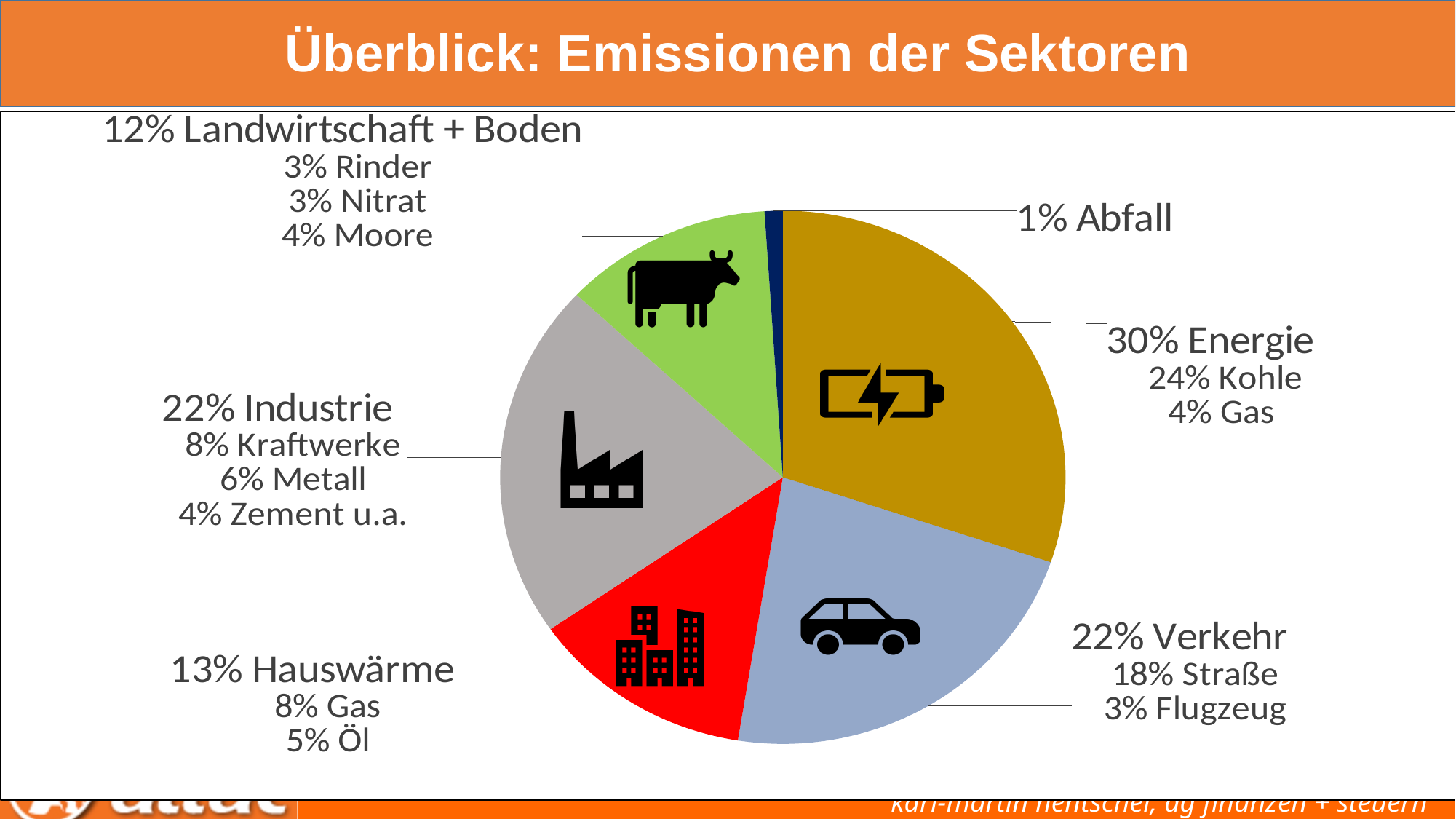
What share of emissions does Abfall account for? 1% What share of emissions does Landwirtschaft + Boden account for? 12% Which has a larger share, Hauswärme or Landwirtschaft + Boden? Hauswärme Which sector has the largest share of emissions? Energie What is the difference in percentage points between the Energie and Verkehr shares? 8 Which sector has the smallest share of emissions? Abfall What kind of chart is shown on the slide? pie chart How many sectors are shown in the pie chart? 6 What share of emissions does the Energie sector account for? 30% What is the title of the slide? Überblick: Emissionen der Sektoren What colour is the Hauswärme slice? red